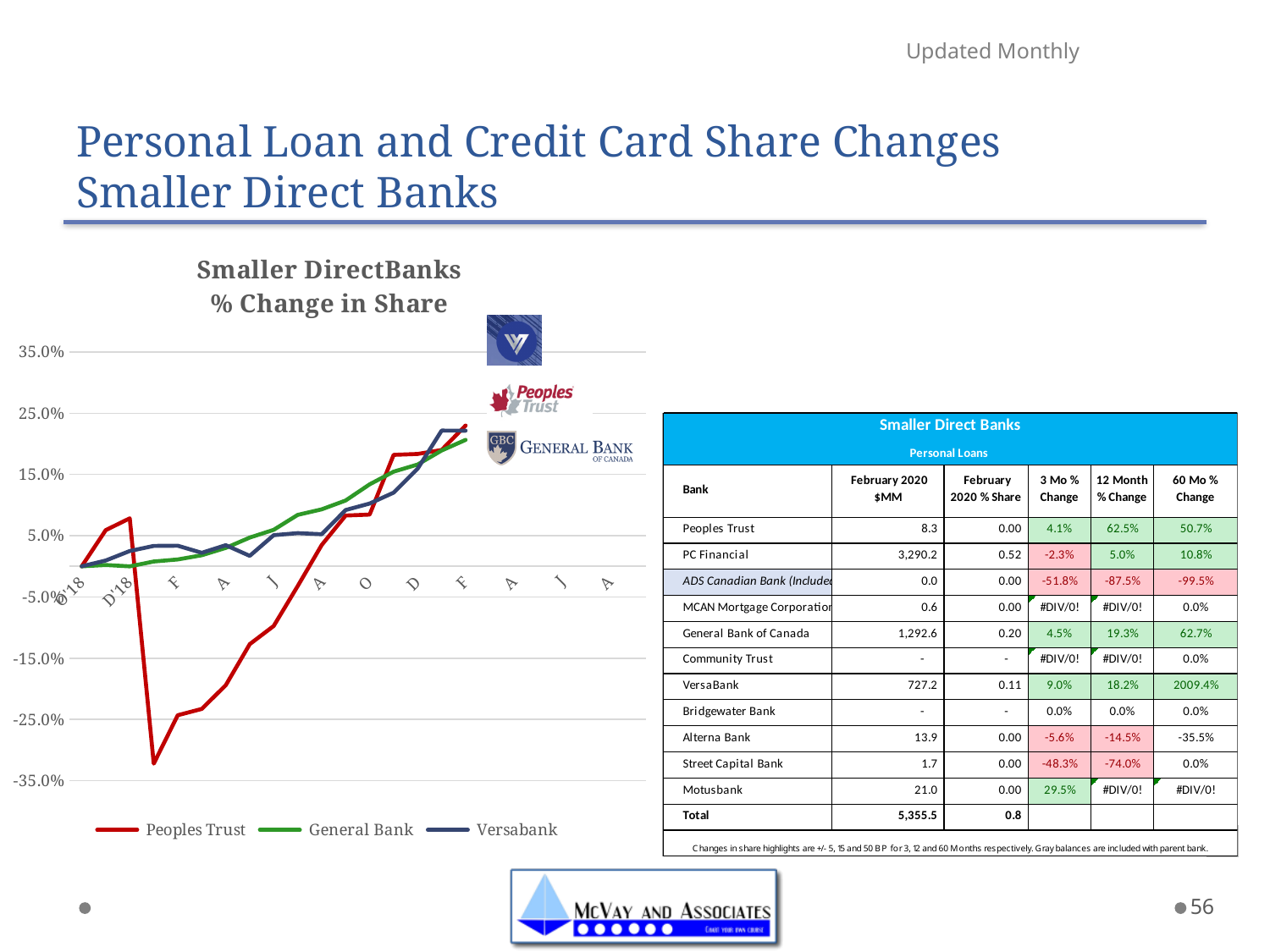
Is the lowest value for Peoples Trust greater or less than -25.0%? less Which series drops to the lowest value on the chart? Peoples Trust What is the title of the chart? Smaller DirectBanks % Change in Share At D'18, which is larger: the value for Peoples Trust or the value for General Bank? Peoples Trust How many series does the chart's legend list? 3 What kind of chart is shown on the slide? Line chart Does the General Bank line generally rise or fall from left to right? Rise Does the Versabank line end higher or lower than it starts? Higher Does the General Bank line ever fall below -5.0%? No Which series is drawn in red on the chart? Peoples Trust Is the value for Versabank at O'18 greater or less than 5.0%? less